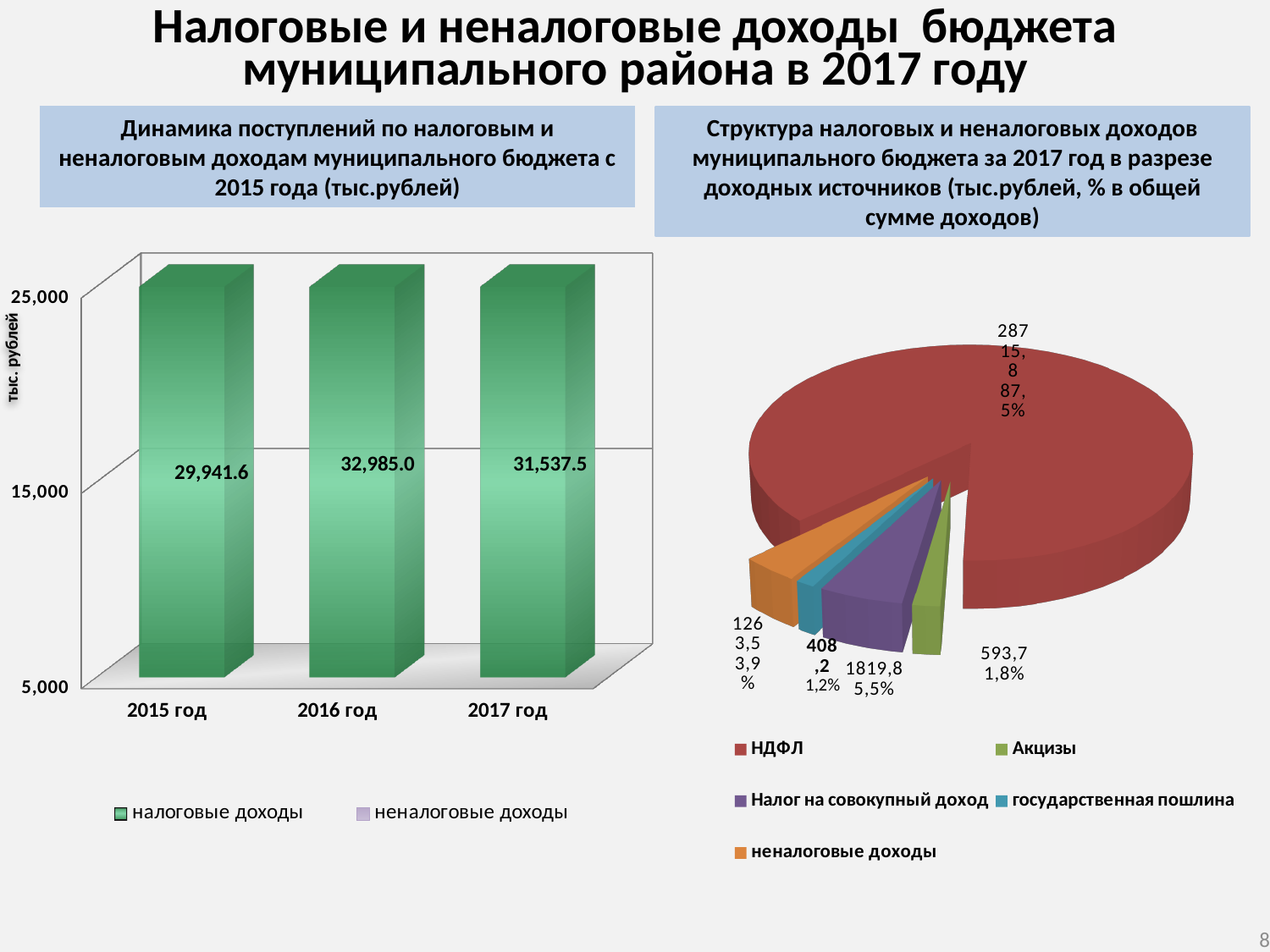
What kind of chart is on the right side of the slide? Pie chart In the right pie chart, which category has the largest slice? НДФЛ In the left bar chart, which year has the lowest value? 2015 год In the left bar chart, what is the value for 2015 год? 29,941.6 In the left bar chart, what is the value for 2016 год? 32,985.0 In the right pie chart, what share of total income does НДФЛ account for? 87,5% In the left bar chart, what is the difference between the values for 2016 год and 2017 год? 1,447.5 In the left bar chart, how many series does the legend list? 2 In the left bar chart, how many years are shown on the x axis? 3 In the right pie chart, how many categories does the legend list? 5 In the left bar chart, which is larger: the value for 2017 год or the value for 2015 год? 2017 год In the left bar chart, which year has the highest value? 2016 год